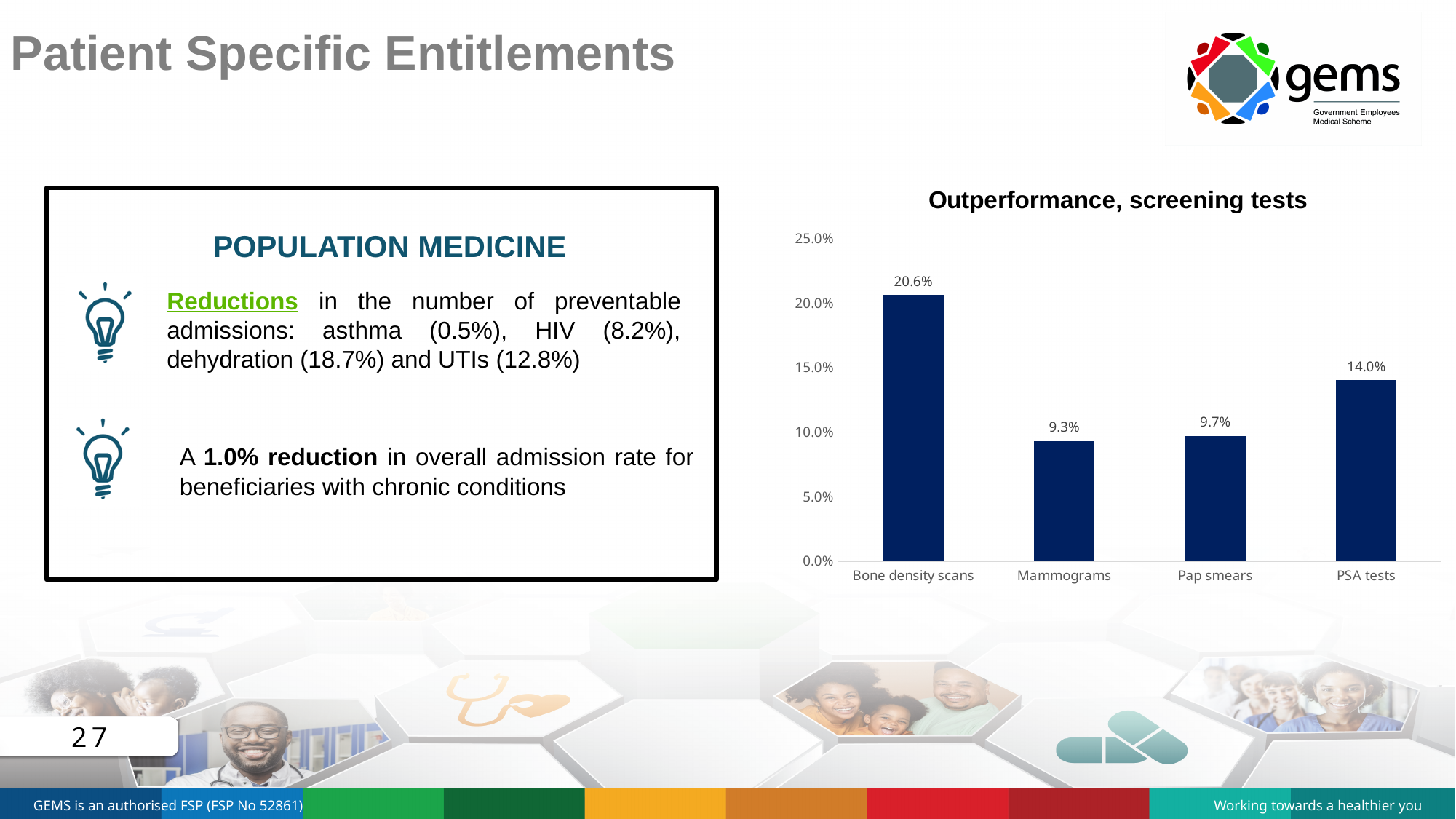
Which is larger, the value for PSA tests or the value for Pap smears? PSA tests What is the value for PSA tests? 14.0% What kind of chart is shown on the slide? Bar chart What is the value for Mammograms? 9.3% What is the difference between the values for Pap smears and Mammograms? 0.4% What is the value for Bone density scans? 20.6% Which category has the lowest value? Mammograms What is the value for Pap smears? 9.7% What is the title of the chart? Outperformance, screening tests How many categories are shown in the chart? 4 What is the difference between the values for Bone density scans and PSA tests? 6.6% Which category has the highest value? Bone density scans